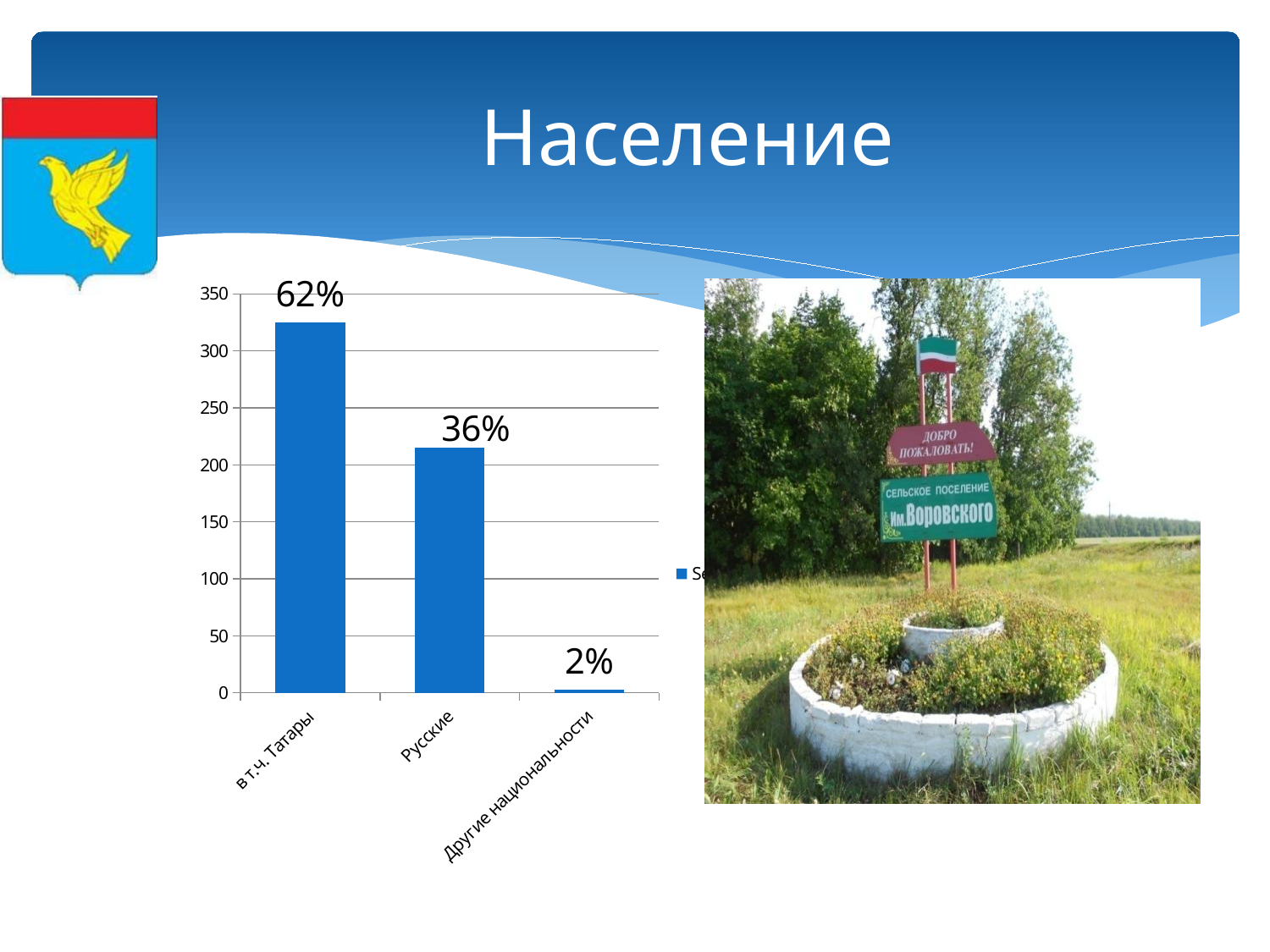
Which bar is taller, Русские or Другие национальности? Русские How many categories are shown on the x axis of the chart? 3 What is the data label shown on the bar for Другие национальности? 2% Which category has the highest bar? в т.ч. Татары Which category has the lowest bar? Другие национальности Is the value for Другие национальности greater or less than 50? less Is the value for в т.ч. Татары greater or less than 300? greater What kind of chart is shown on the slide? Bar chart Do the bar values rise or fall from left to right along the x axis? Fall What is the data label shown on the bar for в т.ч. Татары? 62% What is the data label shown on the bar for Русские? 36% Is the value for Русские greater or less than 250? less